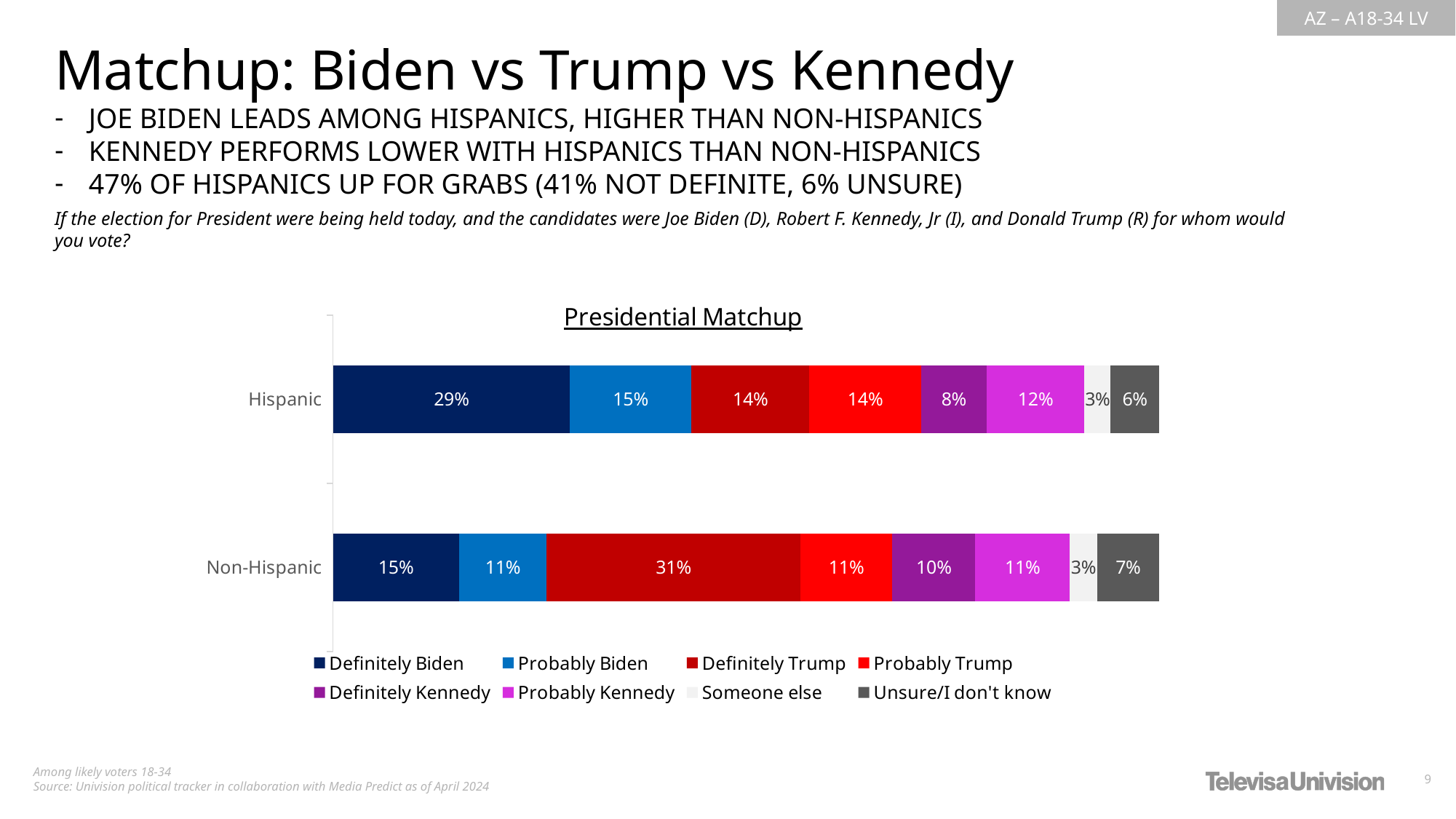
What is the value for Definitely Biden among Hispanic voters? 29% How many series does the legend list? 8 What is the value for Unsure/I don't know among Non-Hispanic voters? 7% What kind of chart is shown on the slide? Stacked bar chart What is the value for Probably Kennedy among Hispanic voters? 12% Which is larger: Definitely Kennedy for Hispanic or Definitely Kennedy for Non-Hispanic voters? Non-Hispanic What is the title of the chart? Presidential Matchup Which segment is the smallest in the Non-Hispanic bar? Someone else How many categories (bars) does the chart show? 2 What is the difference between Definitely Biden for Hispanic and Definitely Biden for Non-Hispanic voters? 14% Which segment is the largest in the Hispanic bar? Definitely Biden What is the value for Definitely Trump among Non-Hispanic voters? 31%